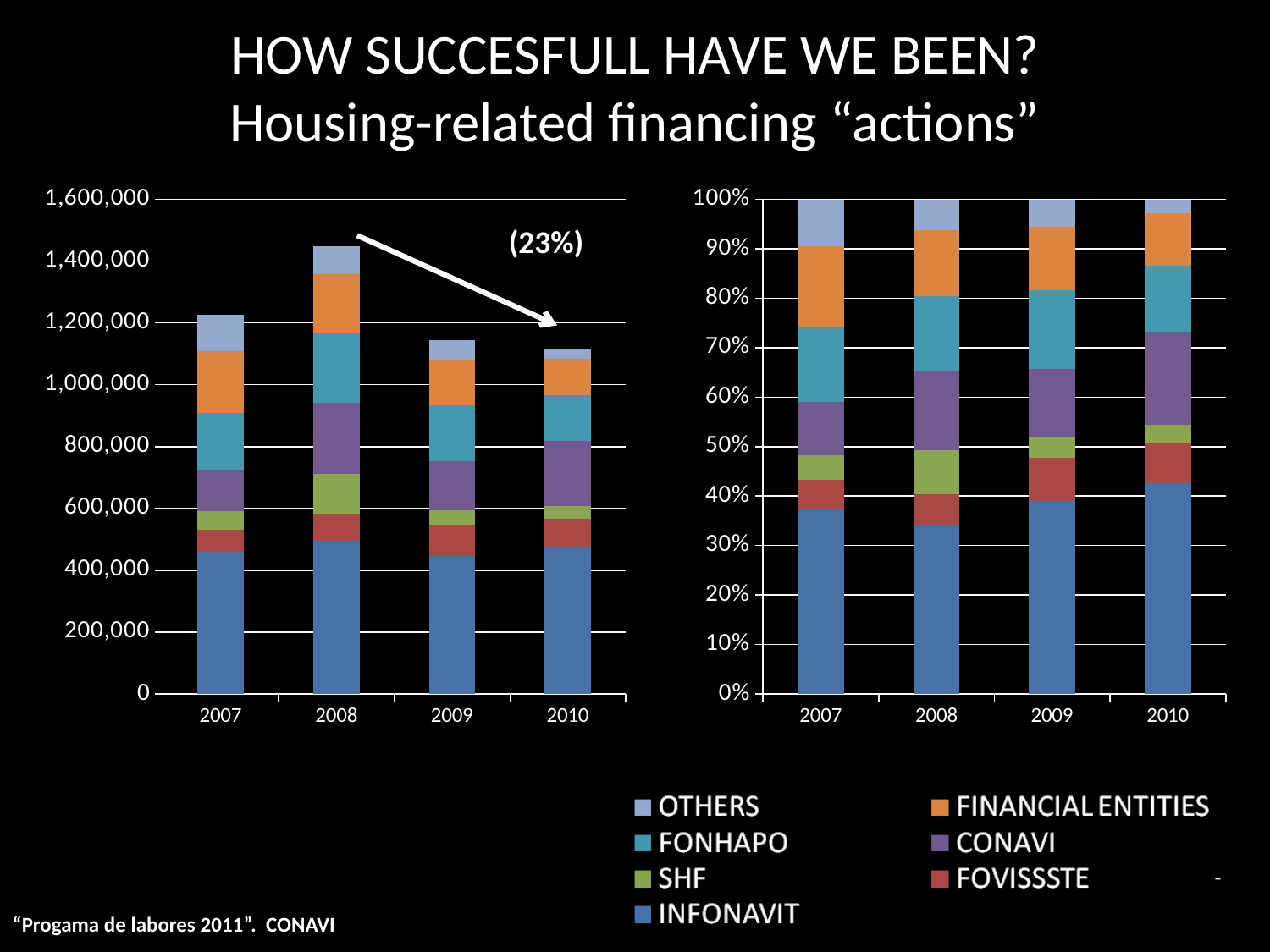
What kind of chart is the left chart on the slide? Stacked bar chart In the left chart, which year has the lowest total bar? 2010 In the right chart, is the INFONAVIT share for 2010 greater or less than 40%? greater In the left chart, which year has the highest total bar? 2008 In the left chart, is the total for 2009 greater or less than 1,200,000? less What percentage is written next to the arrow on the left chart? (23%) In the left chart, which year has a larger total bar, 2008 or 2009? 2008 In the left chart, is the total for 2008 greater or less than 1,400,000? greater How many series does the legend list? 7 In the left chart, do the total bars rise or fall from 2008 to 2010? fall How many years are shown on the x axis of the left chart? 4